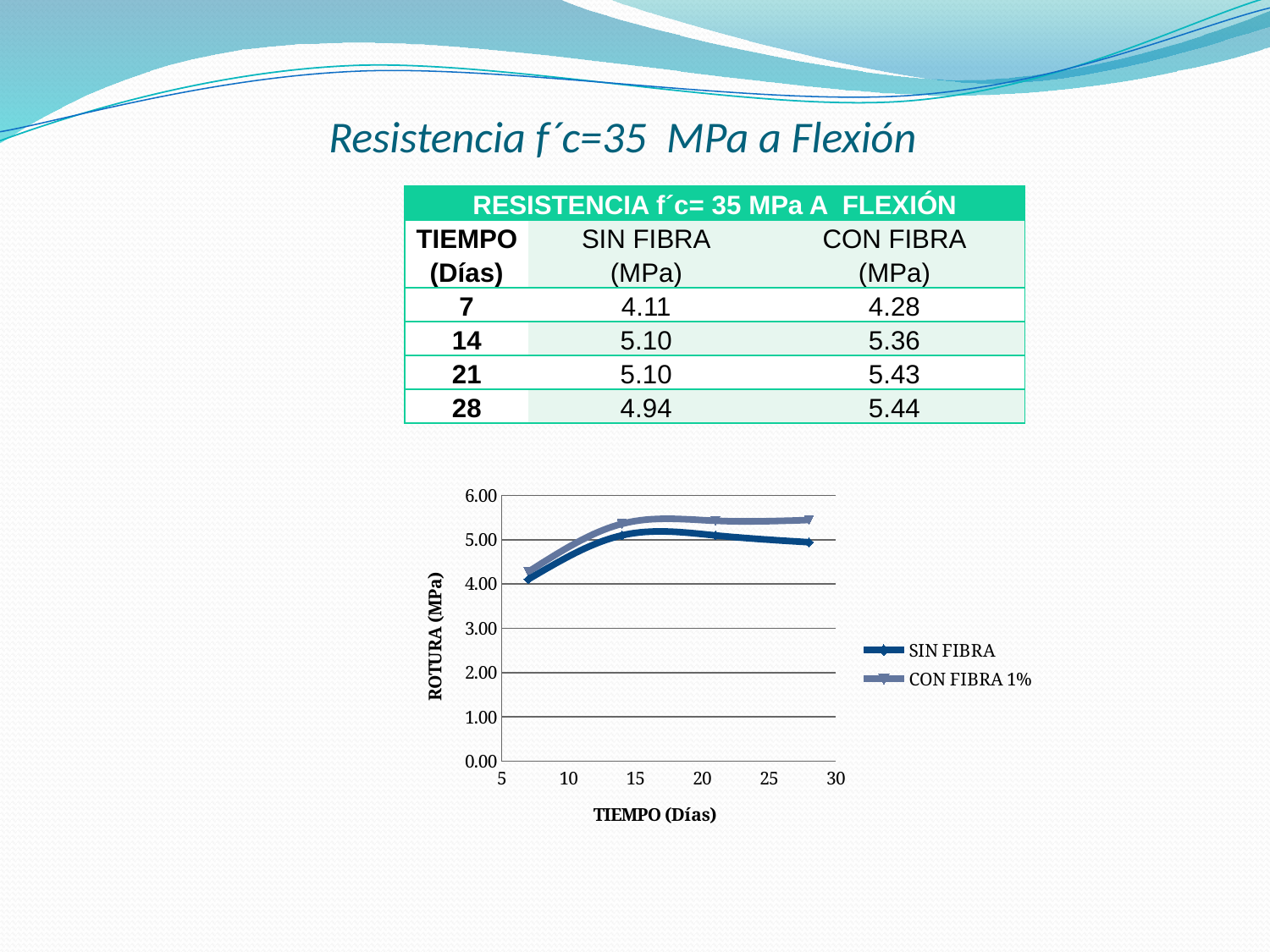
What is the label of the chart's vertical axis? ROTURA (MPa) Does the SIN FIBRA series rise or fall between 21 and 28 days? fall What kind of chart is shown on the slide? line chart Is the CON FIBRA 1% value at 28 days greater or less than 5.00 in the chart? greater Is the SIN FIBRA value at 7 days greater or less than 5.00 in the chart? less Which series has the higher value at 28 days in the chart? CON FIBRA 1% What are the two series named in the chart legend? SIN FIBRA and CON FIBRA 1% According to the table on the slide, what is the CON FIBRA value at 28 days? 5.44 How many data points are plotted for each series in the chart? 4 How many series does the chart legend list? 2 Using the table values, what is the difference between CON FIBRA and SIN FIBRA at 28 days? 0.50 According to the table on the slide, what is the SIN FIBRA value at 7 days? 4.11